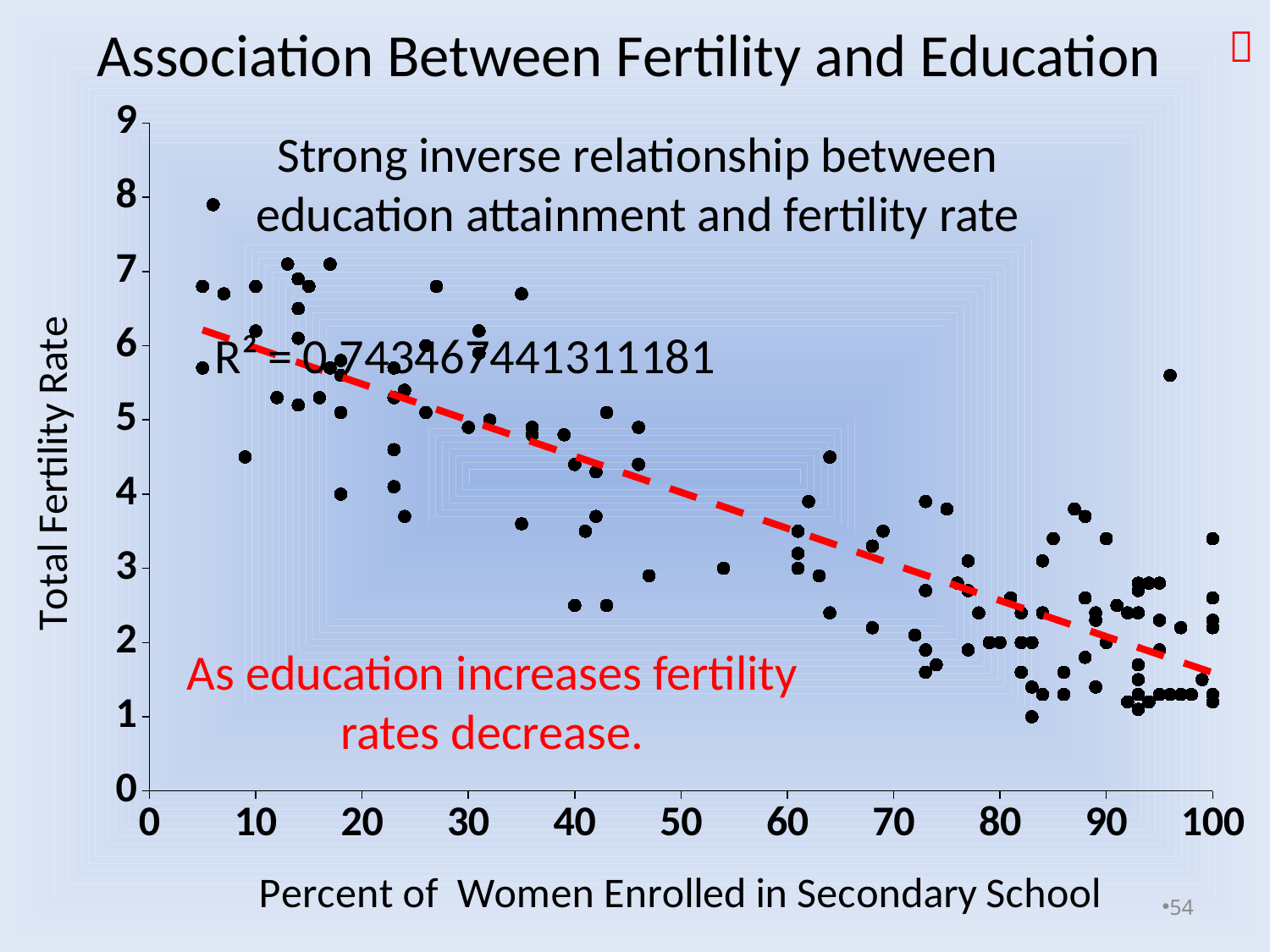
Is the total fertility rate for the point at about 96 percent enrollment greater or less than 5? greater What is the label of the y axis? Total Fertility Rate What is the label of the x axis? Percent of Women Enrolled in Secondary School Which has the higher total fertility rate: the point at about 6 percent enrollment near the top of the chart or the point at about 96 percent enrollment? the point at about 6 percent enrollment What kind of chart is shown on the slide? scatter plot What is the maximum value shown on the x axis? 100 Are the total fertility rate values for the points at 100 percent enrollment greater or less than 4? less What is the R² value printed on the chart? 0.743467441311181 Is the highest plotted total fertility rate value greater or less than 7? greater What is the maximum value shown on the y axis? 9 As the percent of women enrolled in secondary school increases along the x axis, do the total fertility rate values generally rise or fall? fall